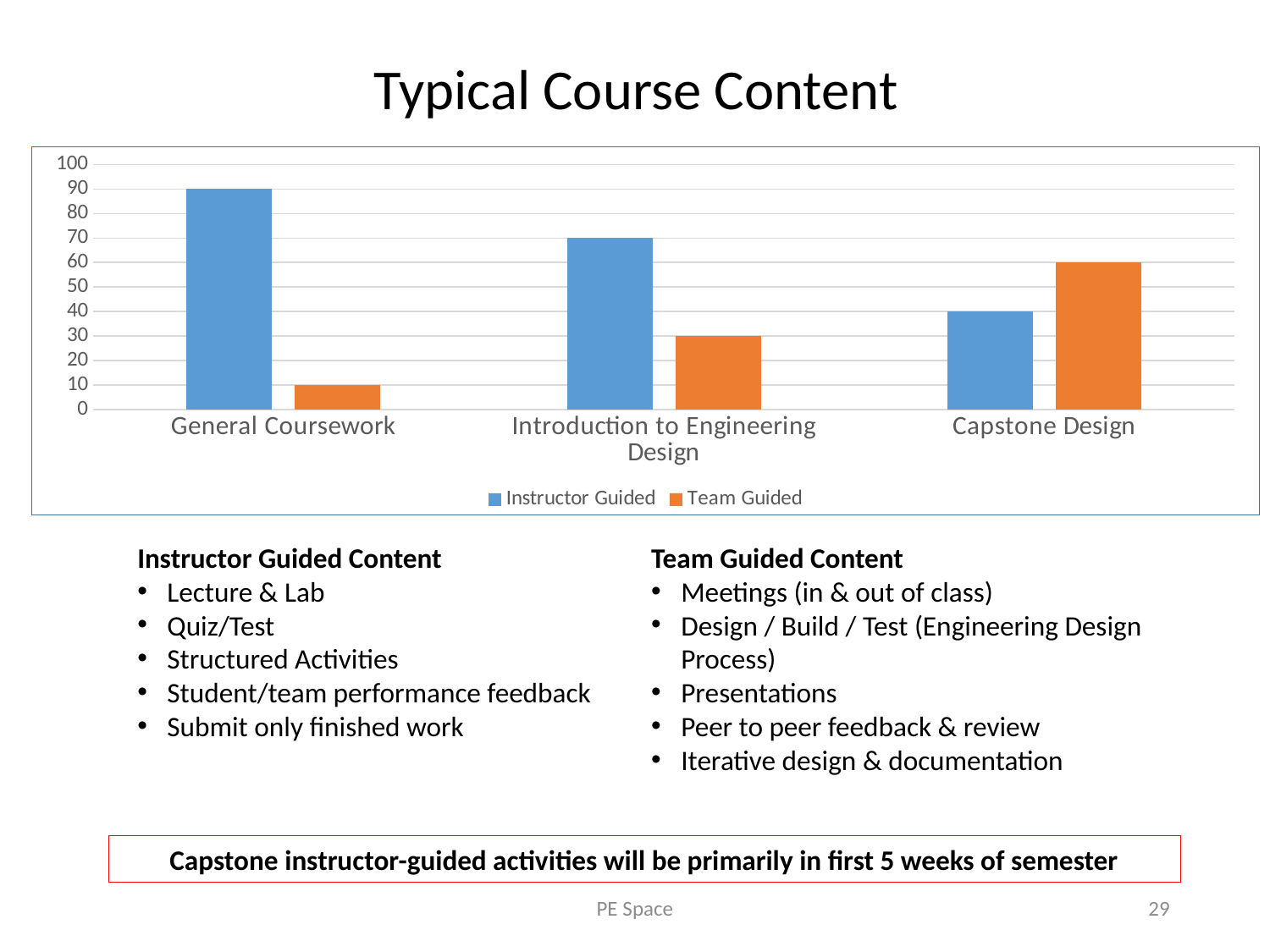
What kind of chart is shown on the slide? bar chart What is the difference between the Instructor Guided and Team Guided values for General Coursework? 80 For Capstone Design, which is larger: Instructor Guided or Team Guided? Team Guided Which category has the lowest Team Guided value? General Coursework How many series does the chart legend list? 2 What is the Instructor Guided value for General Coursework? 90 Which colour represents the Team Guided series in the chart? orange What is the Team Guided value for Capstone Design? 60 Does the Instructor Guided value fall or rise across the categories from left to right? fall What is the Instructor Guided value for Introduction to Engineering Design? 70 Which category has the highest Instructor Guided value? General Coursework How many categories are shown on the x axis of the chart? 3